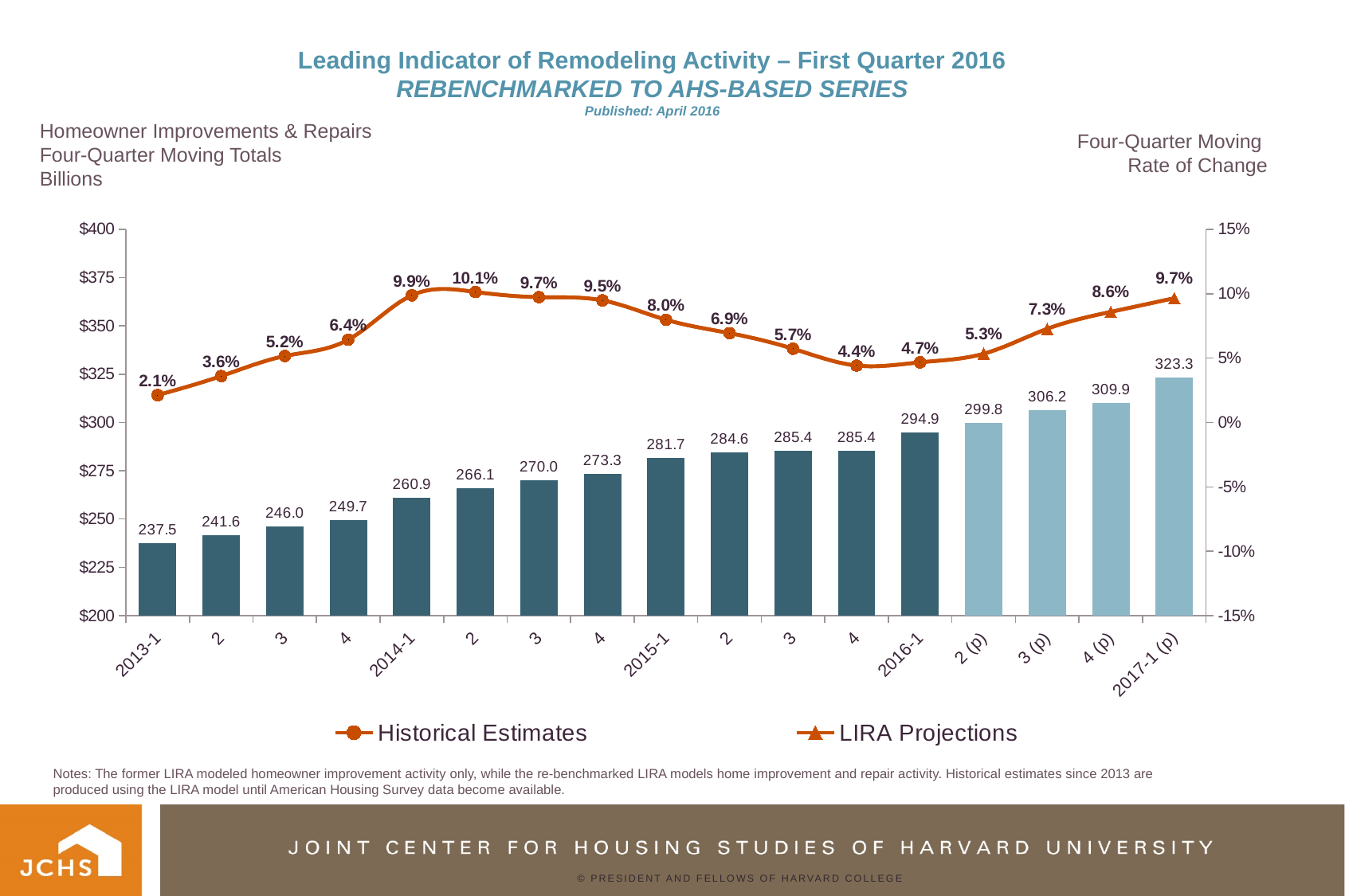
How many series does the legend list? 2 What is the four-quarter moving total for 2016-1? 294.9 What are the two legend entries on the chart? Historical Estimates and LIRA Projections What kinds of chart are combined on this slide? Bar chart and line chart Which period has the lowest four-quarter moving total? 2013-1 What is the projected four-quarter moving total for 2017-1 (p)? 323.3 How many periods are shown on the x axis? 17 What is the difference between the four-quarter moving totals for 2017-1 (p) and 2016-1? 28.4 Which is larger, the rate of change for 2015-1 or for 2016-2 (p)? 2015-1 What is the four-quarter moving rate of change for 2014-2? 10.1% Do the four-quarter moving totals rise or fall from 2013-1 to 2017-1 (p)? Rise Which period has the highest four-quarter moving rate of change? 2014-2